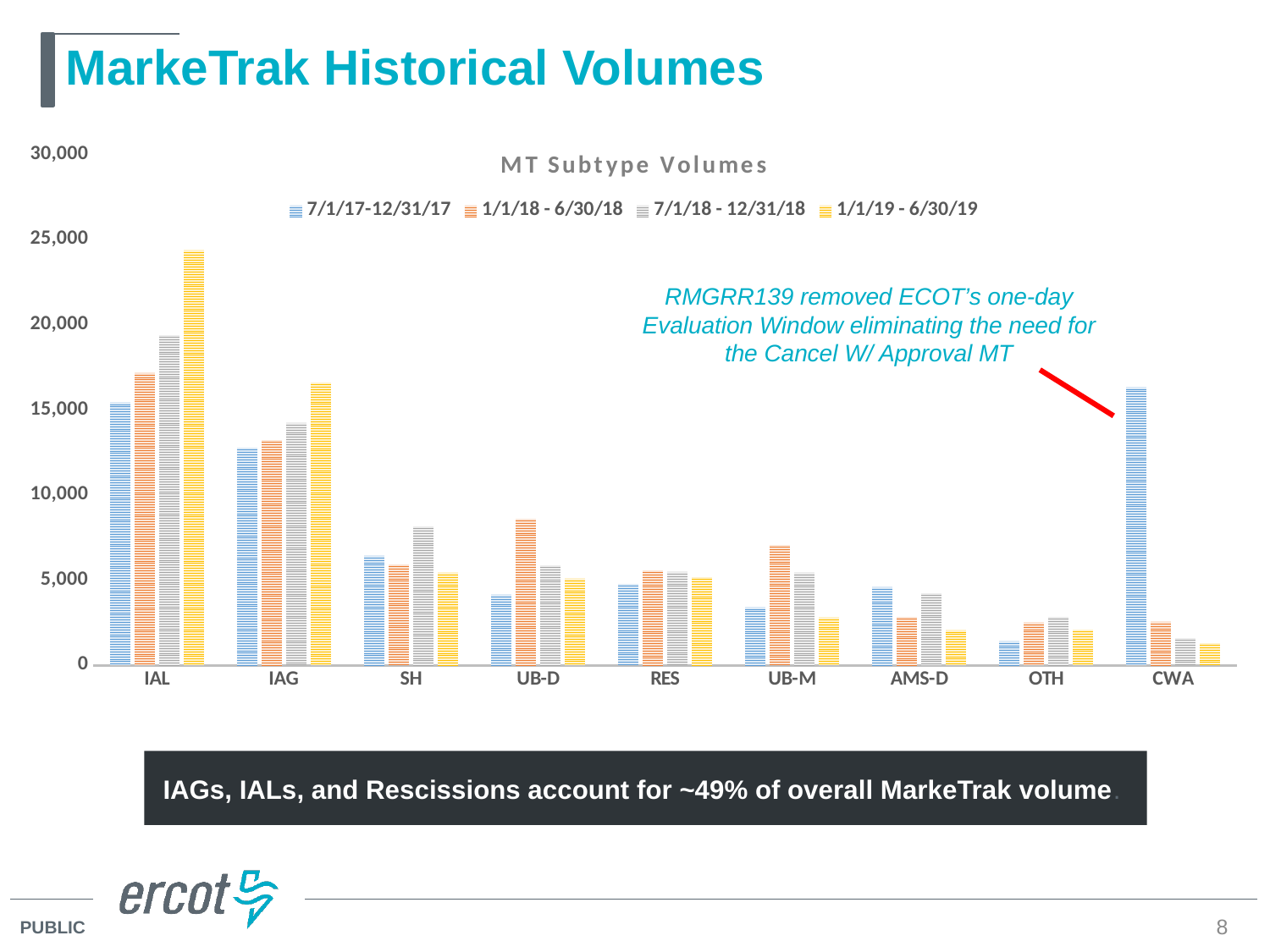
How many series does the legend list? 4 Which category has the highest value for the 1/1/19 - 6/30/19 series? IAL Is the value for UB-D in the 1/1/18 - 6/30/18 series greater or less than 5,000? greater What kind of chart is shown on the slide? bar chart Is the value for IAL in the 1/1/19 - 6/30/19 series greater or less than 20,000? greater Which category has the lowest value for the 7/1/17-12/31/17 series? OTH Is the value for CWA in the 7/1/17-12/31/17 series greater or less than 15,000? greater For IAL, do the values rise or fall across the four periods from 7/1/17-12/31/17 to 1/1/19 - 6/30/19? rise How many MT subtype categories are shown on the x axis? 9 For SH, which series has the larger value: 7/1/18 - 12/31/18 or 1/1/19 - 6/30/19? 7/1/18 - 12/31/18 For CWA, which series has the larger value: 7/1/17-12/31/17 or 1/1/19 - 6/30/19? 7/1/17-12/31/17 What is the title of the chart? MT Subtype Volumes